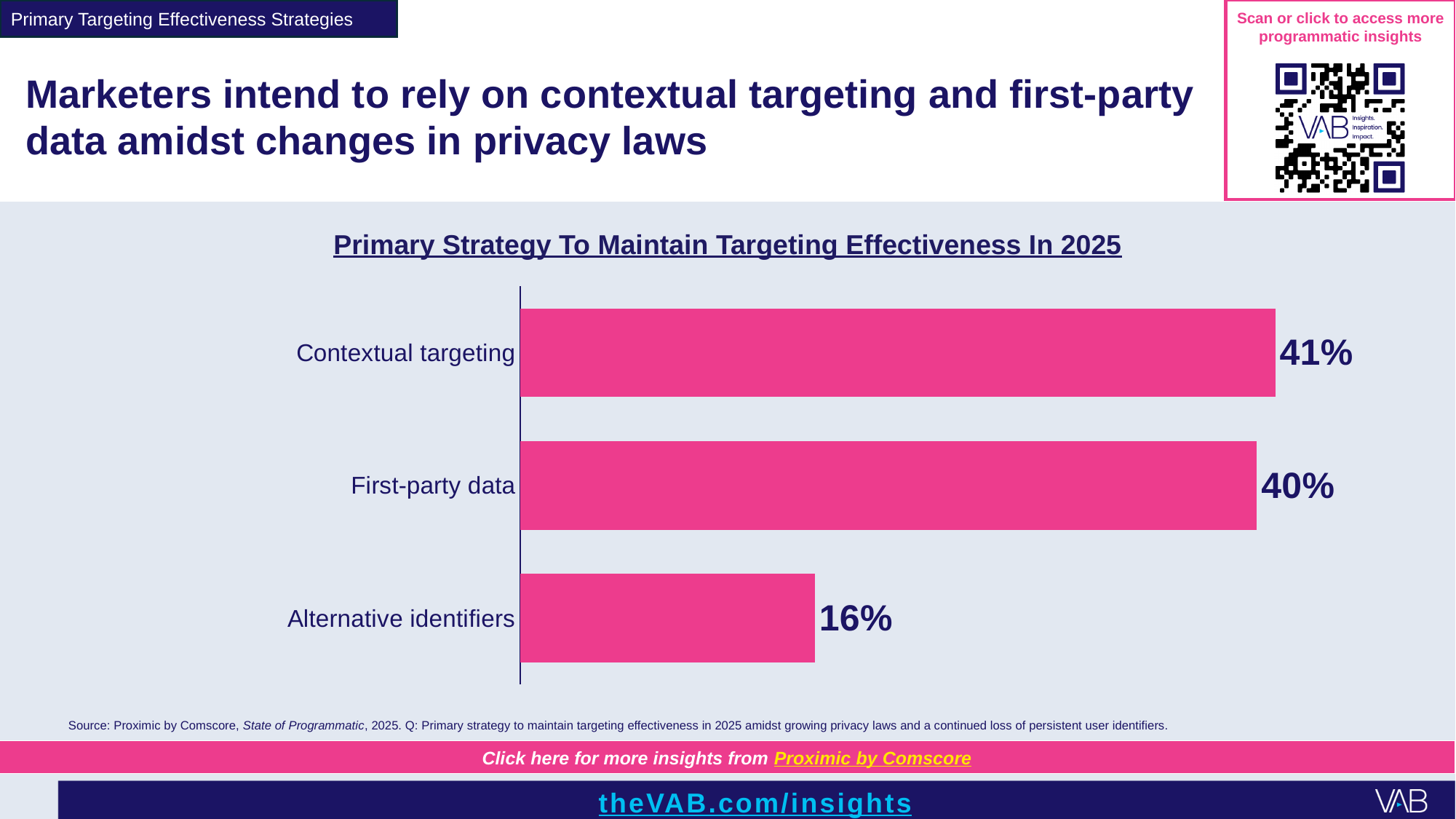
What is the title of the chart? Primary Strategy To Maintain Targeting Effectiveness In 2025 What percentage of marketers cite contextual targeting as their primary strategy to maintain targeting effectiveness in 2025? 41% What is the value shown for First-party data? 40% What is the difference in percentage points between Contextual targeting and First-party data? 1 What is the difference in percentage points between Contextual targeting and Alternative identifiers? 25 Which strategy has the lowest value in the chart? Alternative identifiers Which is larger, the value for First-party data or the value for Alternative identifiers? First-party data What is the value shown for Alternative identifiers? 16% What colour are the bars in the chart? Pink Which strategy has the highest value in the chart? Contextual targeting What kind of chart is shown on the slide? Bar chart How many strategies are shown in the chart? 3